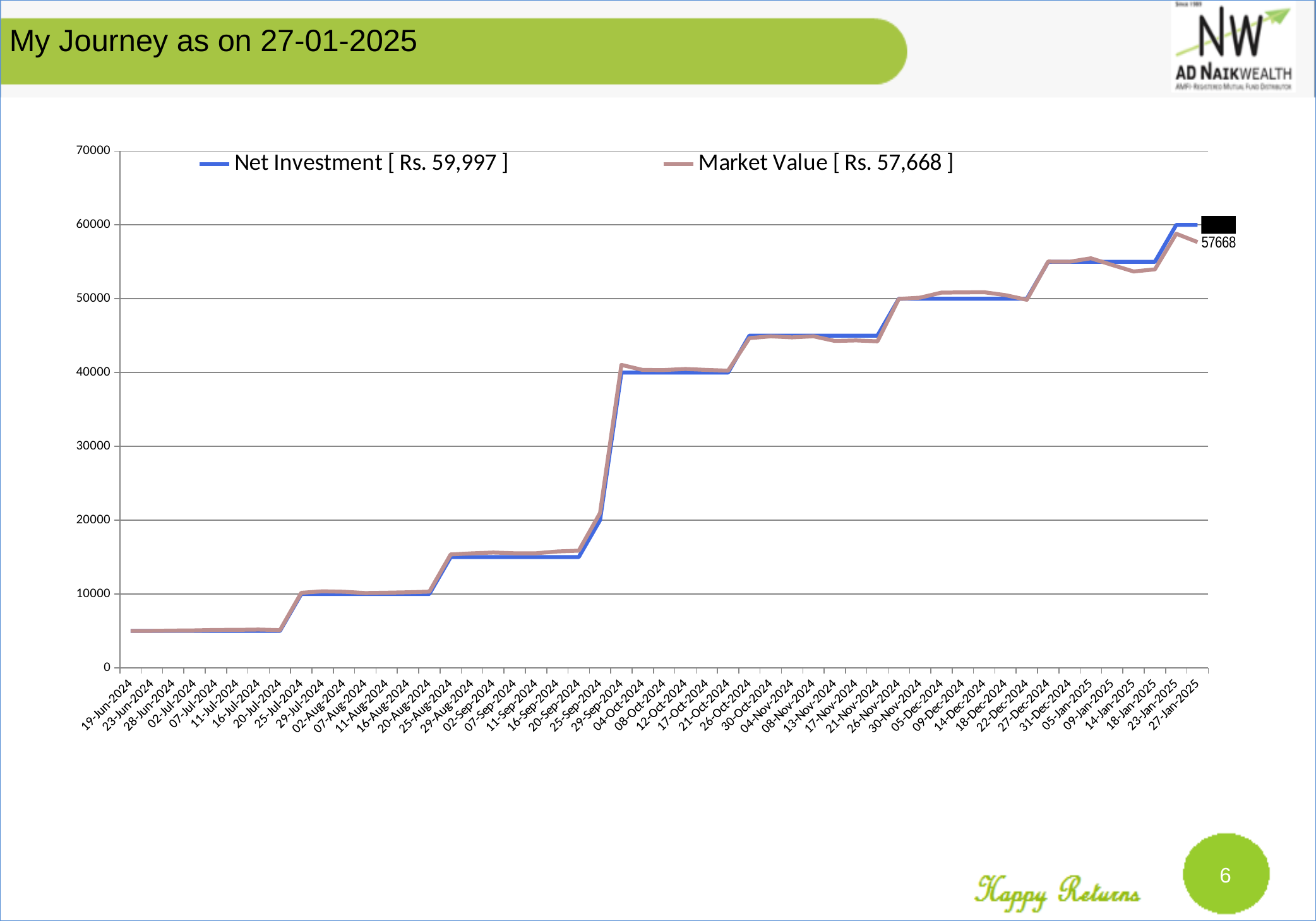
What is the difference between the Net Investment and Market Value amounts shown in the legend? Rs. 2,329 Is the Market Value on 25-Aug-2024 greater or less than 20000? less Is the Net Investment value on 04-Oct-2024 greater or less than 30000? greater How many series does the chart's legend list? 2 What colour is the Net Investment line? blue Do the Net Investment values generally rise or fall from 19-Jun-2024 to 27-Jan-2025? rise What kind of chart is shown on the slide? line chart What is the Market Value on 27-Jan-2025 according to the data label? 57668 What are the two series named in the legend? Net Investment and Market Value What Net Investment amount is shown in the legend? Rs. 59,997 What Market Value amount is shown in the legend? Rs. 57,668 On 27-Jan-2025, which is larger, Net Investment or Market Value? Net Investment